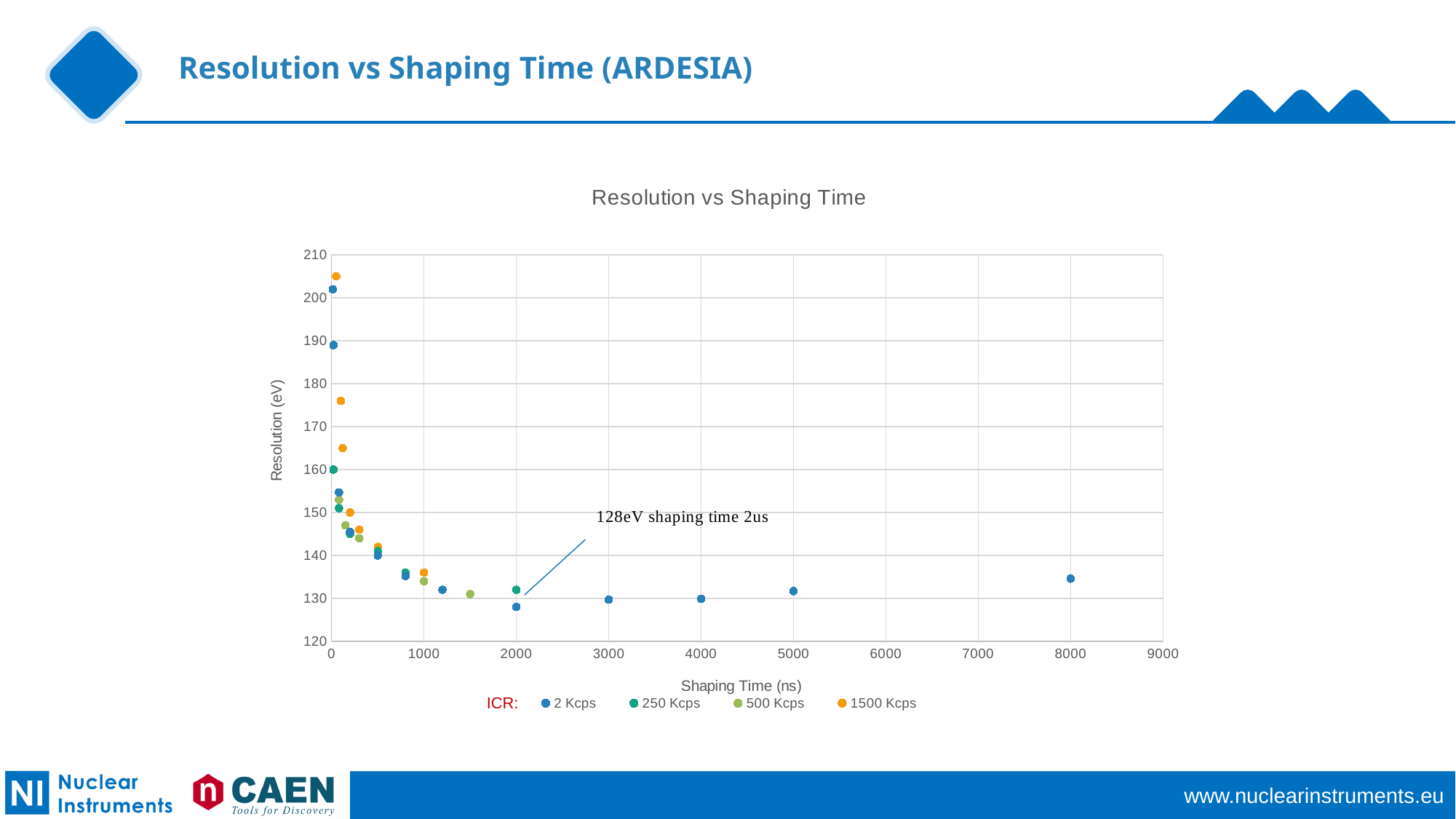
Do the 1500 Kcps values rise or fall as shaping time increases? fall Is the highest value of the 1500 Kcps series greater or less than 200? greater Which series has the point at the largest shaping time (8000 ns)? 2 Kcps How many series does the legend list? 4 What kind of chart is shown on the slide? scatter chart Is the value for the 2 Kcps series at 8000 ns greater or less than 130? greater Is the value for the 2 Kcps series at 8000 ns greater or less than 140? less What is the title of the chart? Resolution vs Shaping Time Which series contains the lowest resolution value on the chart? 2 Kcps What is the label of the y axis? Resolution (eV) According to the annotation, what is the resolution for the 2 Kcps series at a shaping time of 2us? 128eV